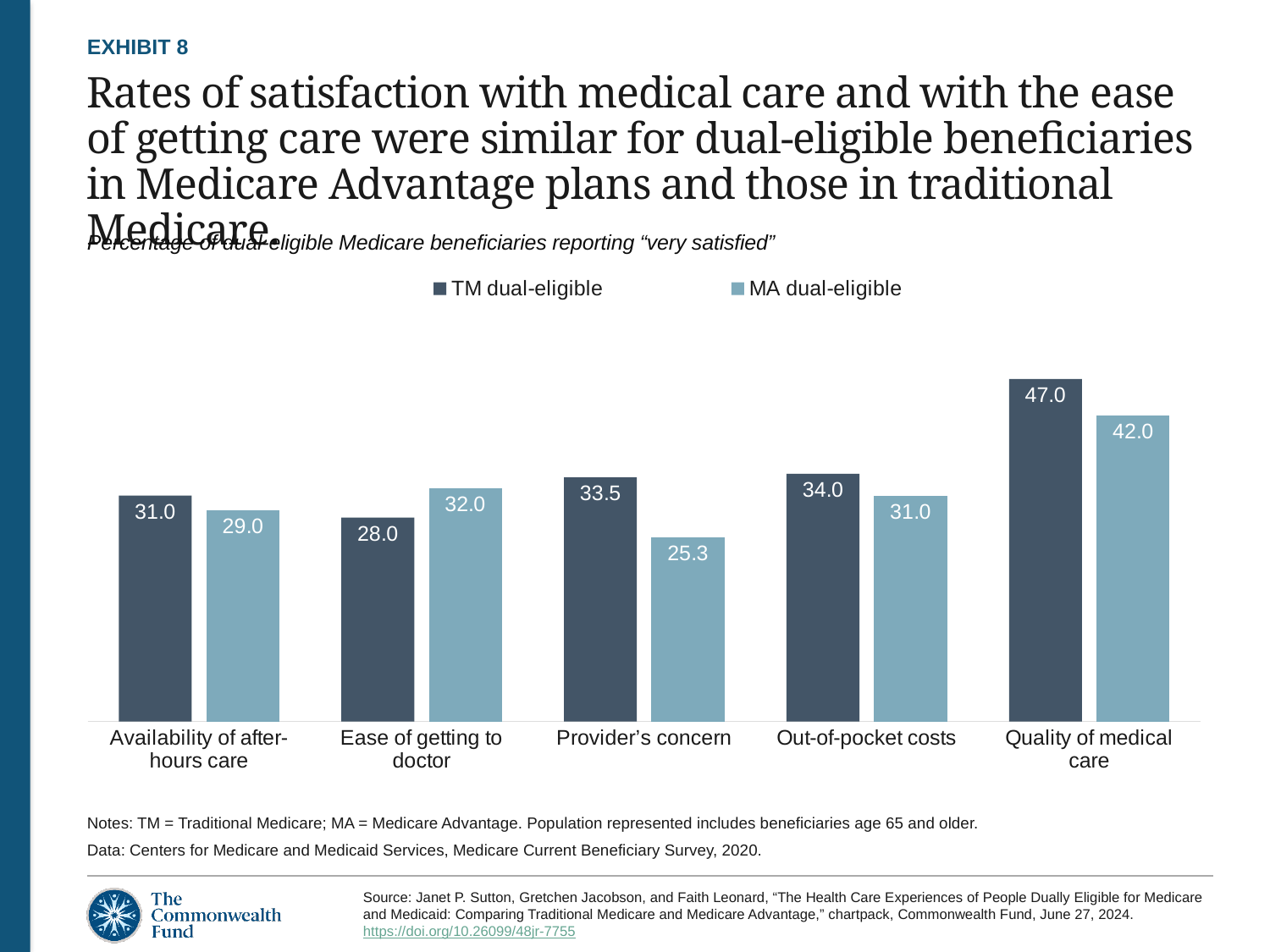
What is the difference between the TM dual-eligible and MA dual-eligible values for Quality of medical care? 5.0 For Ease of getting to doctor, which series has the larger value, TM dual-eligible or MA dual-eligible? MA dual-eligible How many categories are shown on the x axis? 5 Which series is shown in the lighter blue colour? MA dual-eligible What kind of chart is shown on the slide? Bar chart What is the difference between the TM dual-eligible and MA dual-eligible values for Provider's concern? 8.2 What is the value for TM dual-eligible for Quality of medical care? 47.0 What is the value for MA dual-eligible for Provider's concern? 25.3 Which category has the highest MA dual-eligible value? Quality of medical care Which category has the lowest TM dual-eligible value? Ease of getting to doctor What is the value for TM dual-eligible for Ease of getting to doctor? 28.0 How many series does the legend list? 2